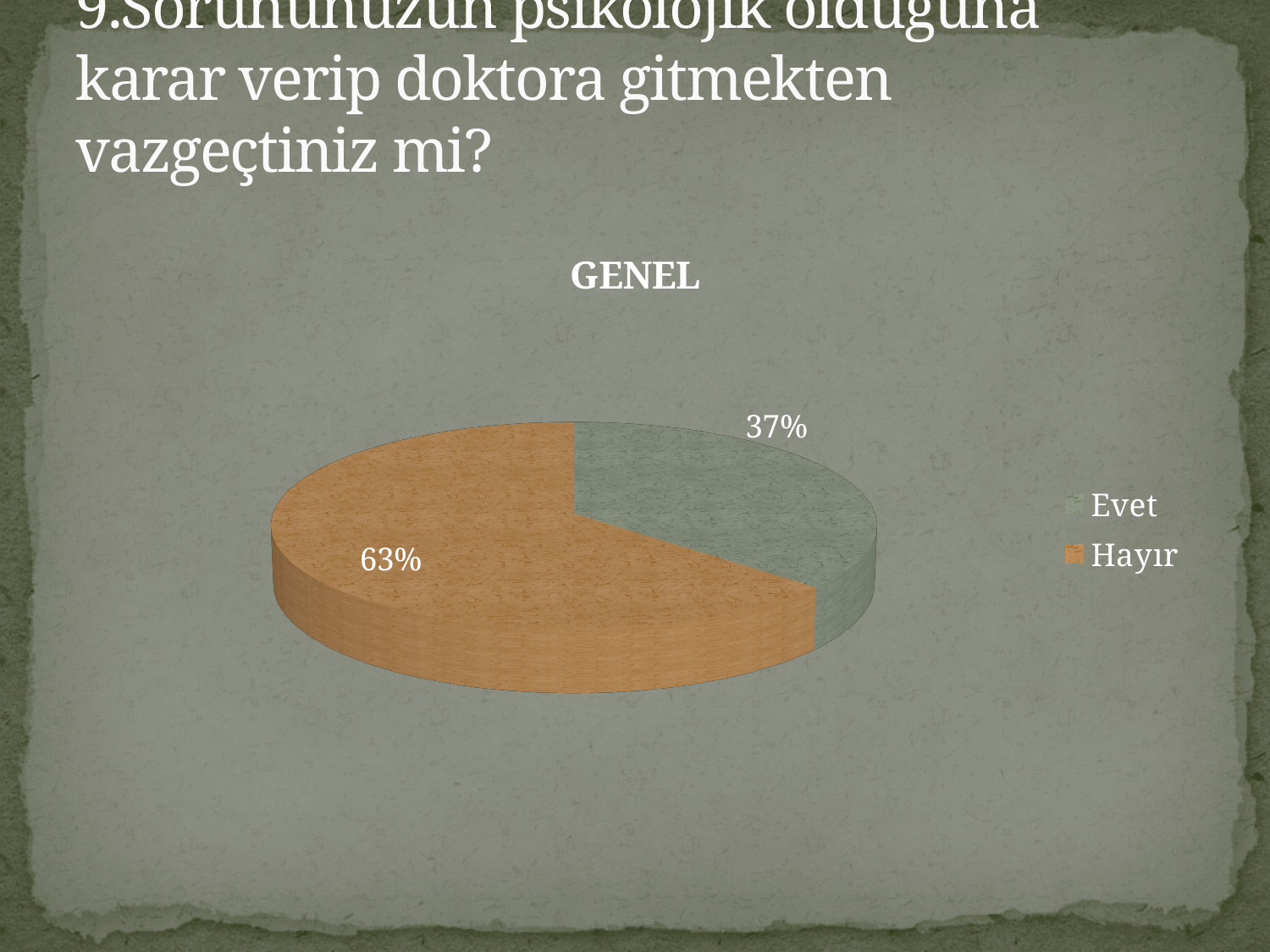
Which slice is the smallest? Evet What share of the pie does Hayır represent? 63% How many slices does the pie chart have? 2 How many entries does the legend list? 2 What share of the pie does Evet represent? 37% What is the difference in percentage points between Hayır and Evet? 26 Which is larger, Evet or Hayır? Hayır What colour is the Hayır slice? orange What kind of chart is shown on the slide? pie chart Which slice is the largest? Hayır What is the title of the chart? GENEL